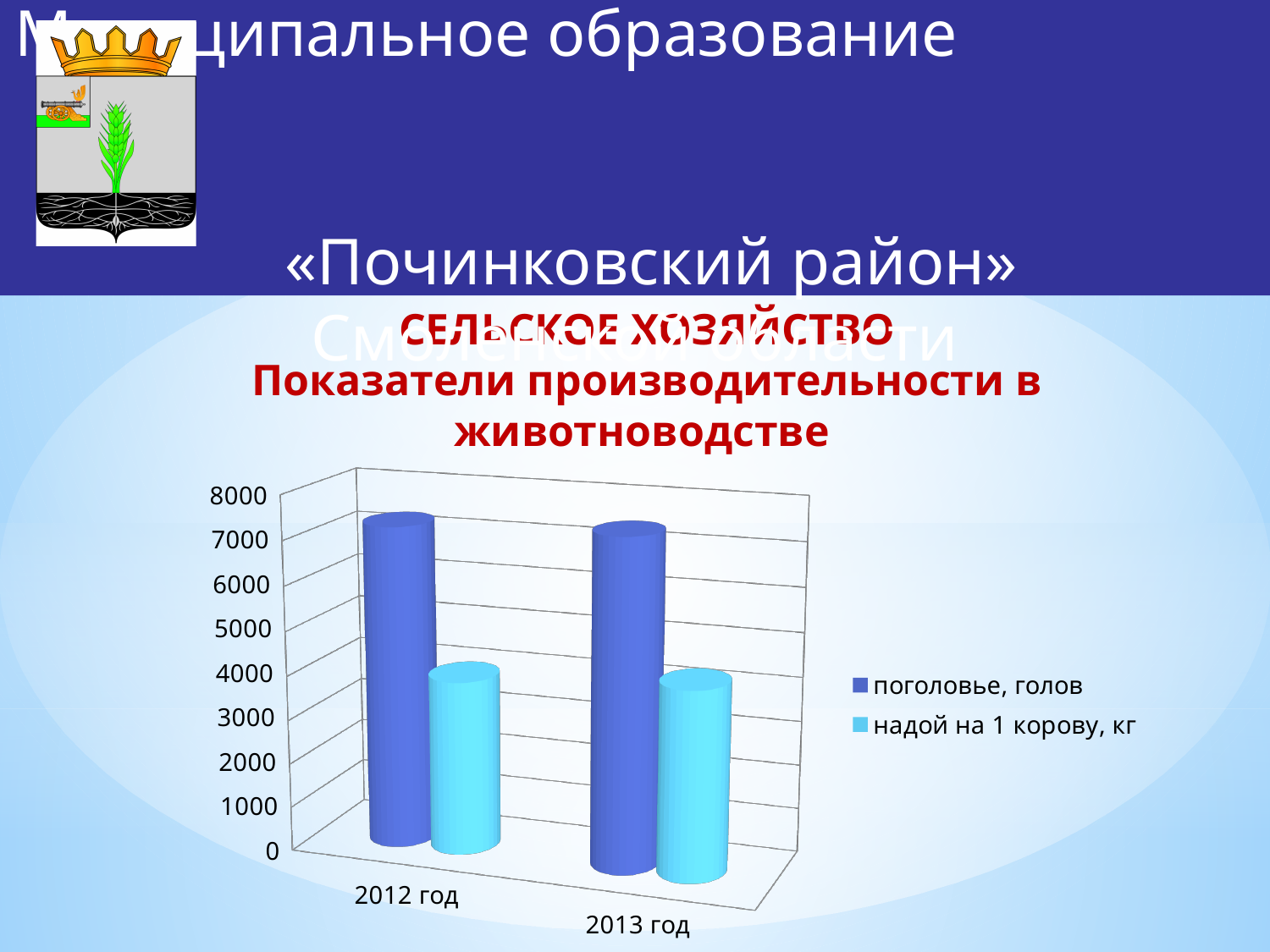
Is the value for надой на 1 корову, кг in 2013 год greater or less than 2000? greater How many series does the chart legend list? 2 In 2013 год, which is larger: поголовье, голов or надой на 1 корову, кг? поголовье, голов Which series is shown in dark blue in the chart legend? поголовье, голов Is the value for поголовье, голов in 2013 год greater or less than 5000? greater Is the value for поголовье, голов in 2012 год greater or less than 6000? greater In 2012 год, which is larger: поголовье, голов or надой на 1 корову, кг? поголовье, голов How many year categories are shown on the x axis of the chart? 2 What kind of chart is shown on the slide? bar chart What is the title of the chart? Показатели производительности в животноводстве Which category label appears first on the x axis of the chart? 2012 год